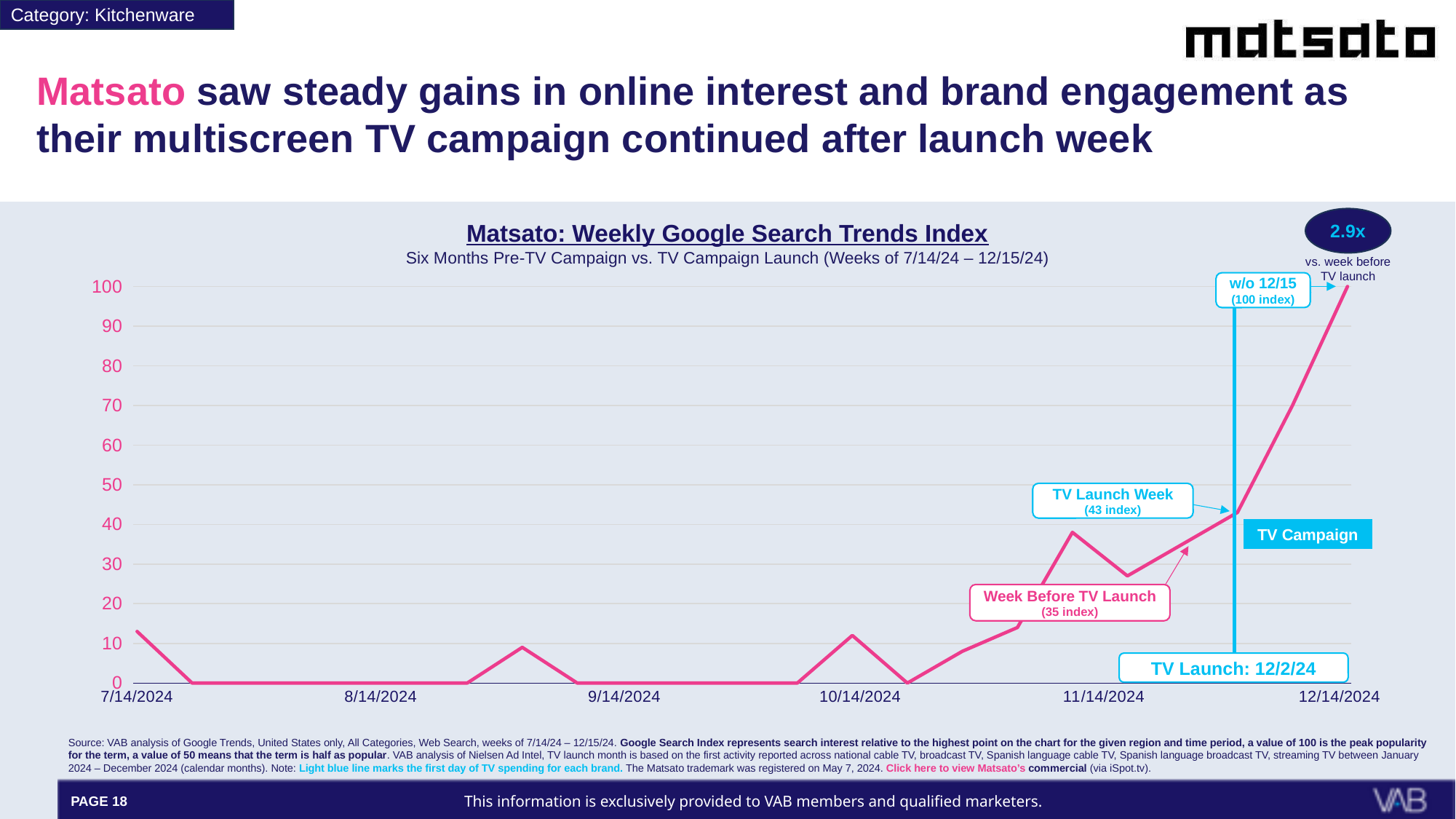
Is the search index value at 7/14/2024 greater or less than 20? less What type of chart is shown on the slide? Line chart Does the search index rise or fall between 11/14/2024 and 12/14/2024? Rise What is the search index value for the week of 12/15? 100 What is the search index value for the Week Before TV Launch? 35 What is the difference between the TV Launch Week index and the Week Before TV Launch index? 8 Which week has the highest search index value on the chart? w/o 12/15 What is the title of the chart? Matsato: Weekly Google Search Trends Index What is the difference between the week of 12/15 index and the TV Launch Week index? 57 What date does the chart mark as the TV Launch? 12/2/24 Which is larger, the index for the TV Launch Week or the index for the Week Before TV Launch? TV Launch Week What is the search index value for the TV Launch Week? 43